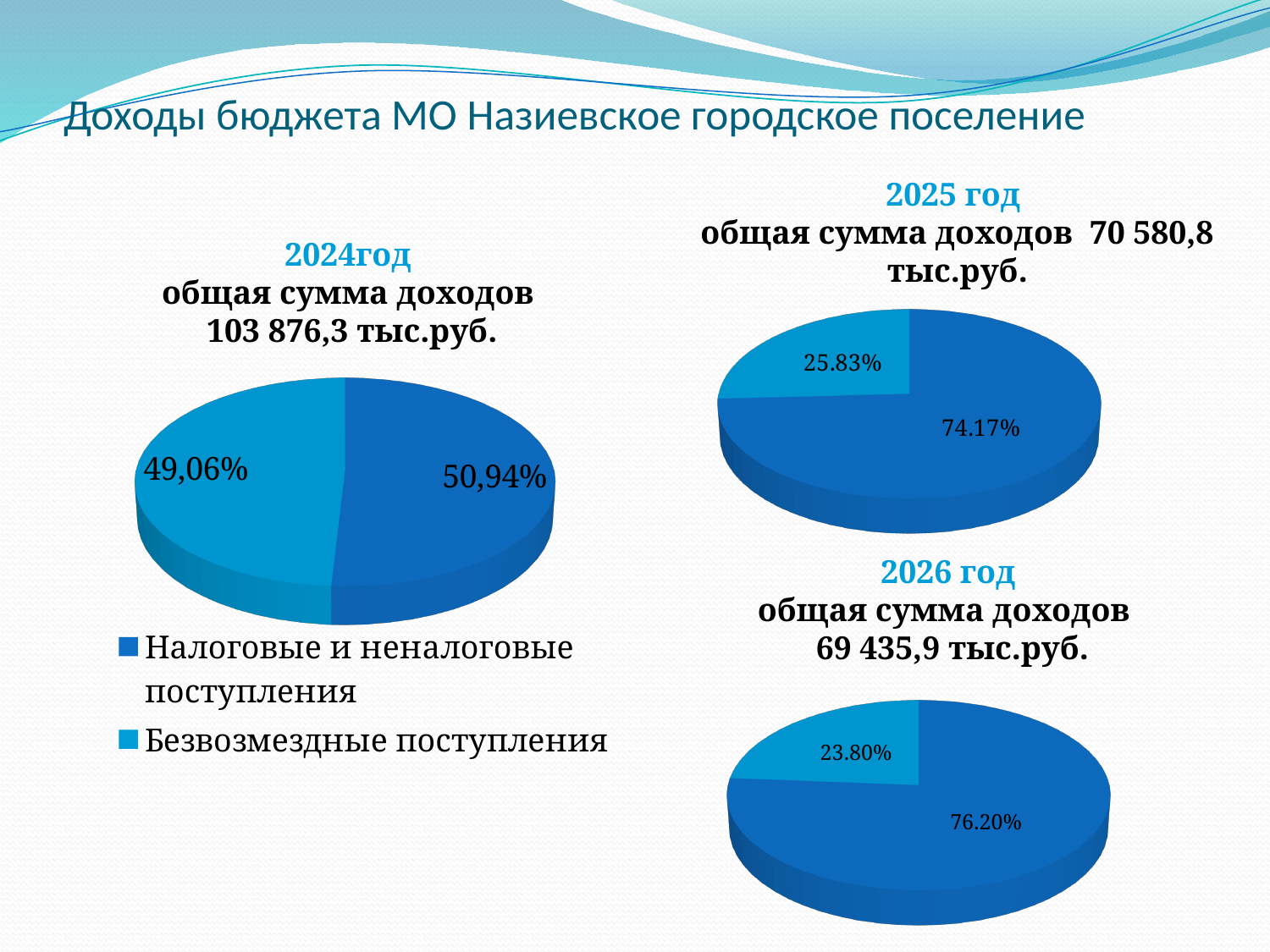
In the 2026 год chart, what is the difference between the two slices' shares? 52.40% In the 2024 год chart, what share is shown for Налоговые и неналоговые поступления? 50,94% In the 2025 год chart, what share is shown for Налоговые и неналоговые поступления? 74.17% In the 2025 год chart, which category has the smallest slice? Безвозмездные поступления In the 2026 год chart, which category has the largest slice? Налоговые и неналоговые поступления How many entries does the legend list? 2 What kind of chart is used for the 2024 год chart? pie chart In the 2026 год chart, what share is shown for Безвозмездные поступления? 23.80% What total income (общая сумма доходов) is stated above the 2025 год chart? 70 580,8 тыс.руб. How many slices does the 2024 год pie chart have? 2